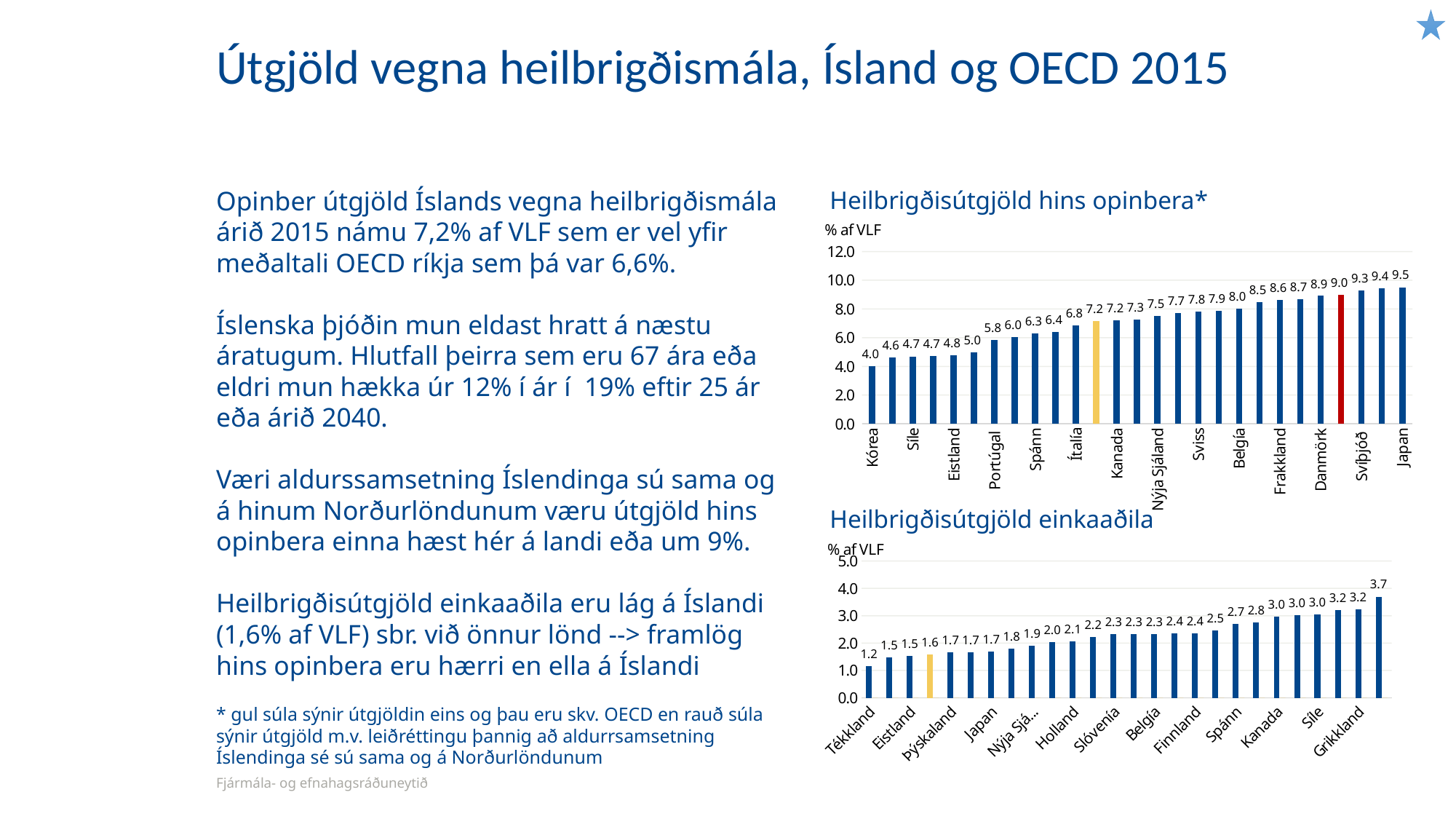
In the bottom chart "Heilbrigðisútgjöld einkaaðila", what is the value for Tékkland? 1.2 What kind of chart is the top chart titled "Heilbrigðisútgjöld hins opinbera*"? bar chart In the bottom chart "Heilbrigðisútgjöld einkaaðila", what is the highest value shown? 3.7 In the top chart "Heilbrigðisútgjöld hins opinbera*", which country has the highest value? Japan In the top chart "Heilbrigðisútgjöld hins opinbera*", what value is shown on the red bar? 9.0 In the top chart "Heilbrigðisútgjöld hins opinbera*", what is the value for Japan? 9.5 In the top chart "Heilbrigðisútgjöld hins opinbera*", what is the value for Kórea? 4.0 In the top chart "Heilbrigðisútgjöld hins opinbera*", which country has the lowest value? Kórea In the bottom chart "Heilbrigðisútgjöld einkaaðila", what value is shown on the yellow bar? 1.6 In the top chart "Heilbrigðisútgjöld hins opinbera*", what is the difference between the values for Japan and Kórea? 5.5 In the top chart "Heilbrigðisútgjöld hins opinbera*", what value is shown on the yellow bar? 7.2 In the bottom chart "Heilbrigðisútgjöld einkaaðila", do the values rise or fall from left to right? rise